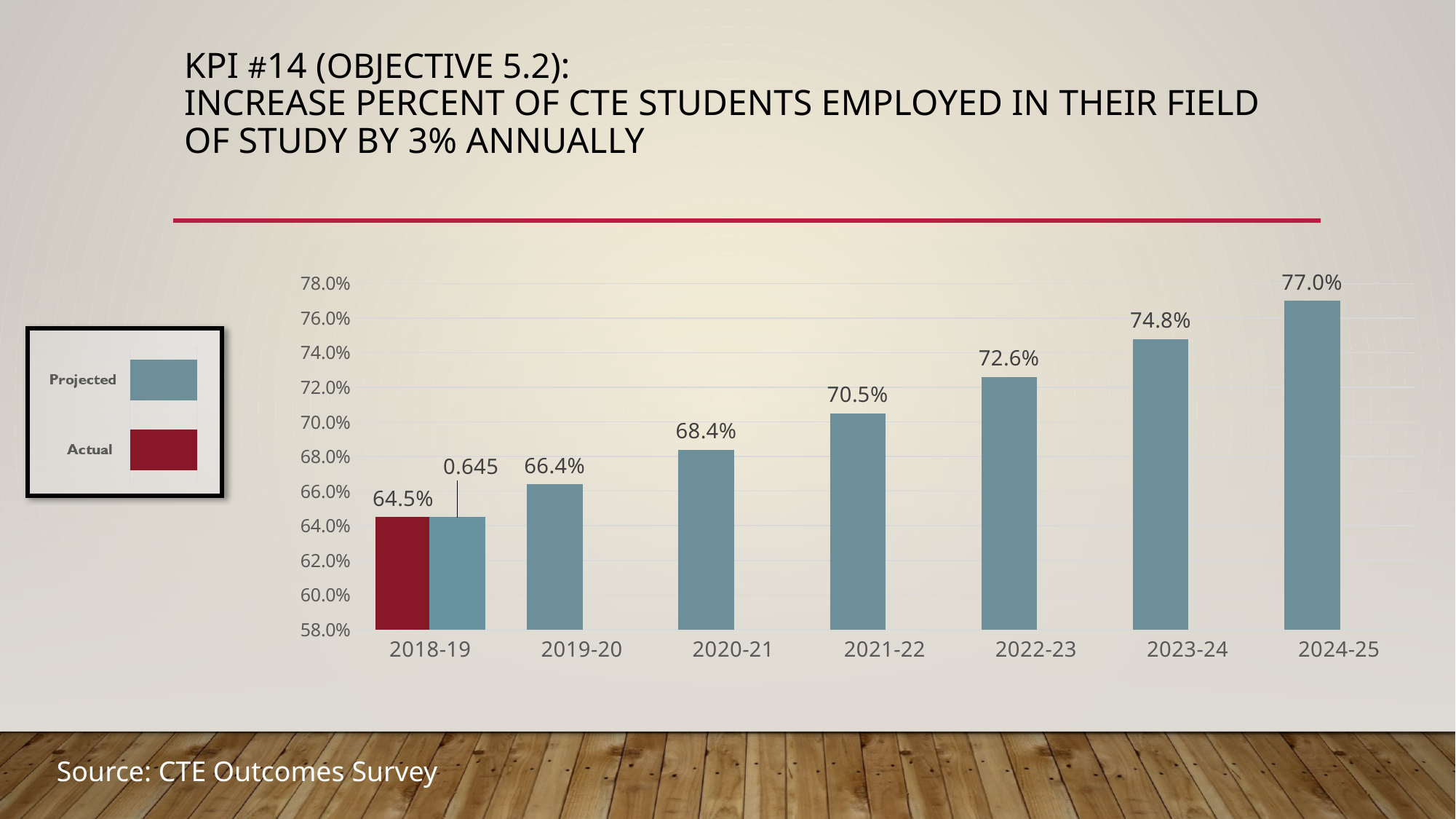
Which year has the highest projected value? 2024-25 What is the projected value for 2024-25? 77.0% Do the projected values rise or fall from 2018-19 to 2024-25? rise What is the actual value shown for 2018-19? 64.5% Which year has the lowest projected value? 2018-19 What is the difference between the projected values for 2024-25 and 2023-24? 2.2% What is the projected value for 2021-22? 70.5% How many years are shown on the x axis? 7 Which is larger, the projected value for 2020-21 or for 2022-23? 2022-23 Is the projected value for 2023-24 greater or less than 74.0%? greater What is the projected value for 2019-20? 66.4% How many series does the legend list? 2